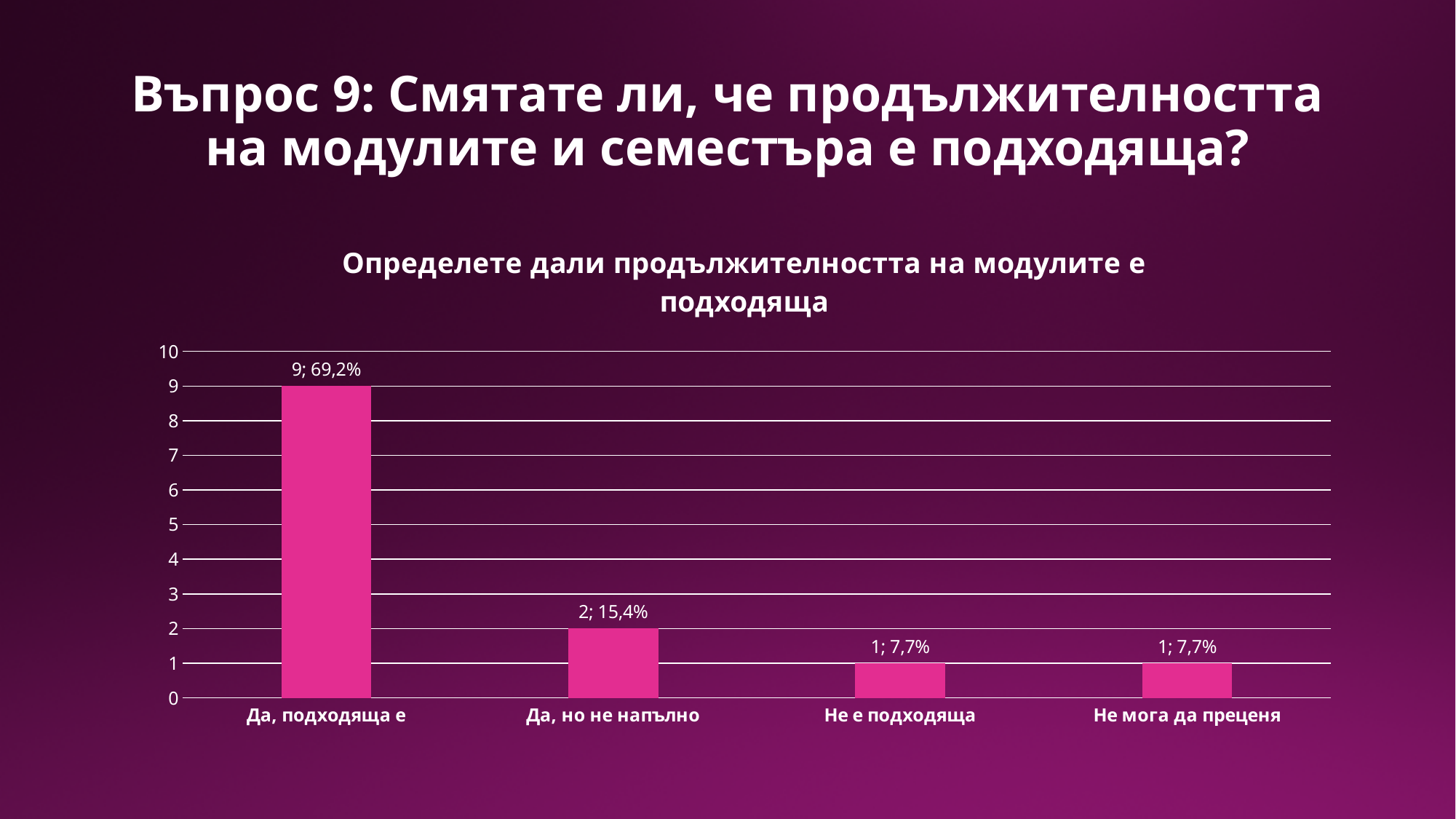
Which category has the highest value? Да, подходяща е What is the total of all four bar values? 13 What percentage is shown for "Да, подходяща е"? 69,2% How many categories are shown on the x axis? 4 Which is larger, the value for "Да, но не напълно" or "Не мога да преценя"? Да, но не напълно What is the difference between the values for "Да, подходяща е" and "Да, но не напълно"? 7 What is the value for "Не е подходяща"? 1 What is the value for "Да, подходяща е"? 9 What is the title of the chart? Определете дали продължителността на модулите е подходяща Is the value for "Да, подходяща е" greater or less than 5? greater What kind of chart is shown? bar chart What percentage is shown for "Да, но не напълно"? 15,4%